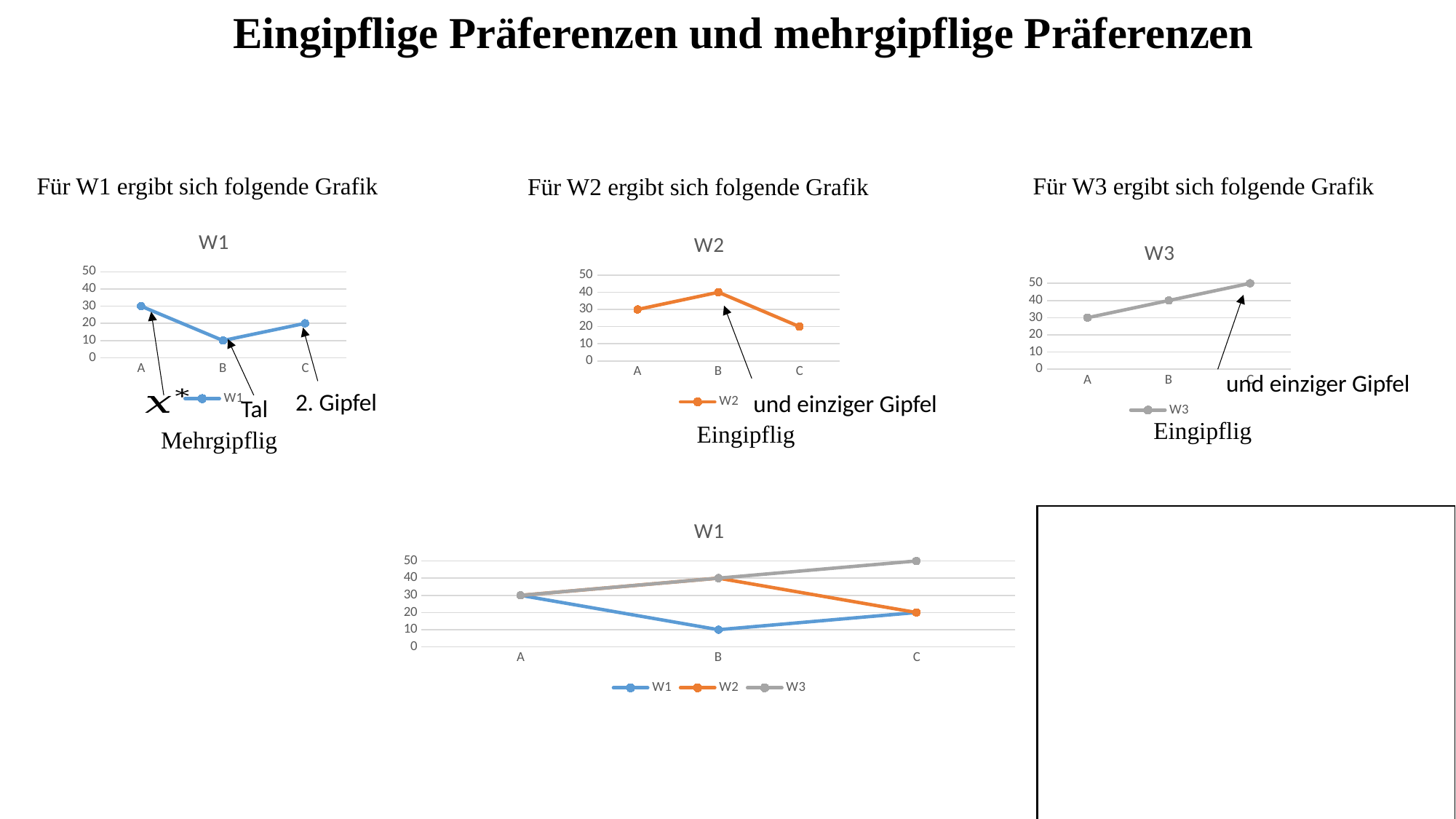
In the top-middle chart titled W2, what is the value at B? 40 In the bottom chart, how many series does the legend list? 3 How many categories are shown on the x axis of the bottom chart? 3 In the top-left chart titled W1, what is the value at B? 10 In the top-right chart titled W3, do the values rise or fall from A to C? rise In the bottom chart, what is the value of the W2 series at C? 20 In the top-left chart titled W1, what is the difference between the values at A and B? 20 In the top-middle chart titled W2, which category has the highest value? B What kind of chart is the top-right chart titled W3? line chart In the top-right chart titled W3, what is the value at C? 50 In the top-left chart titled W1, which category has the lowest value? B In the bottom chart, which series has the higher value at C, W1 or W3? W3